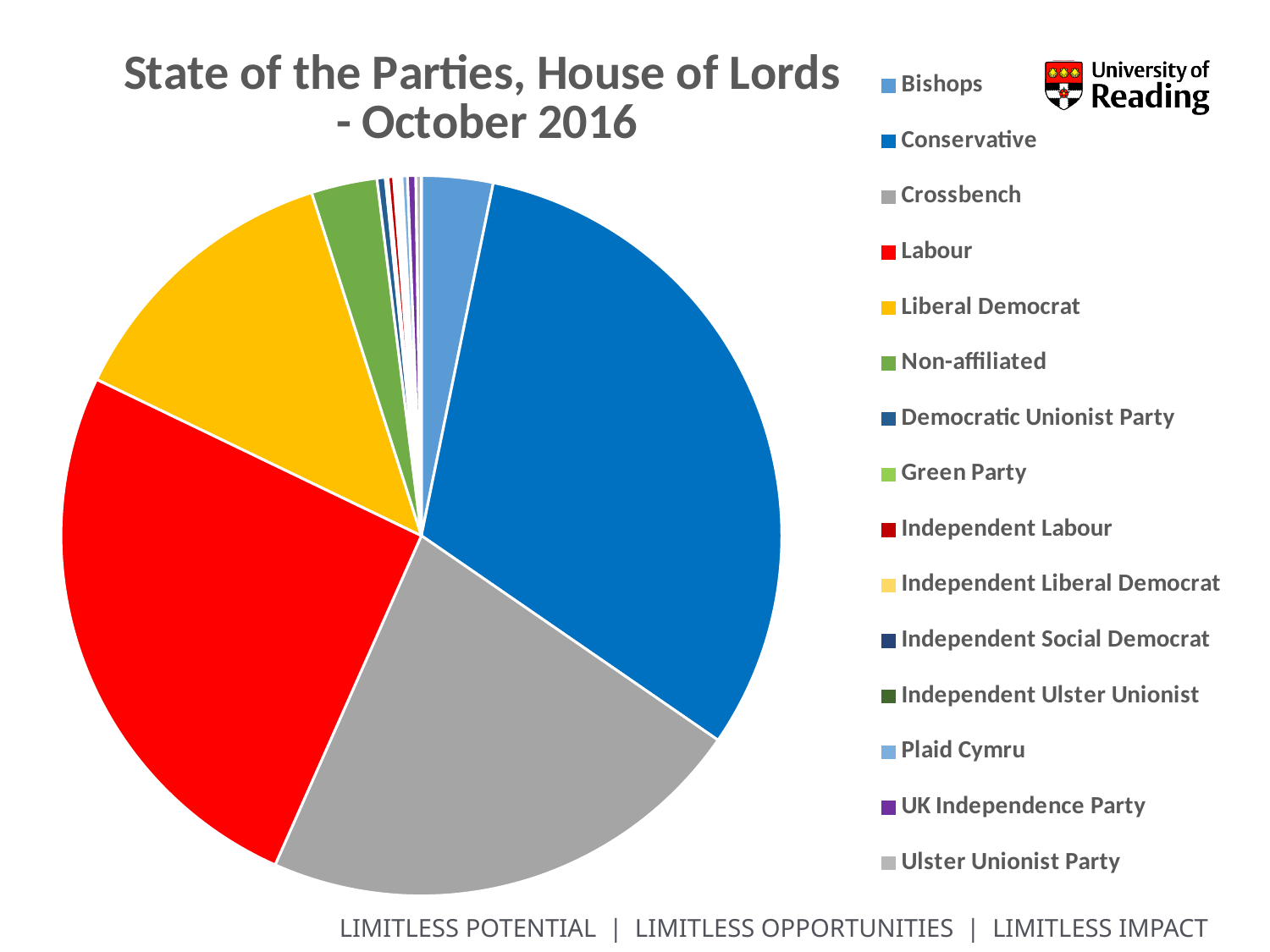
What kind of chart is shown on the slide? pie chart How many categories does the legend of the pie chart list? 15 What is the title of the chart? State of the Parties, House of Lords - October 2016 Which party has the largest slice of the pie chart? Conservative Which slice is larger, Crossbench or Liberal Democrat? Crossbench Which slice is larger, Labour or Bishops? Labour Which slice is larger, Liberal Democrat or Non-affiliated? Liberal Democrat Which colour represents Labour in the pie chart? red